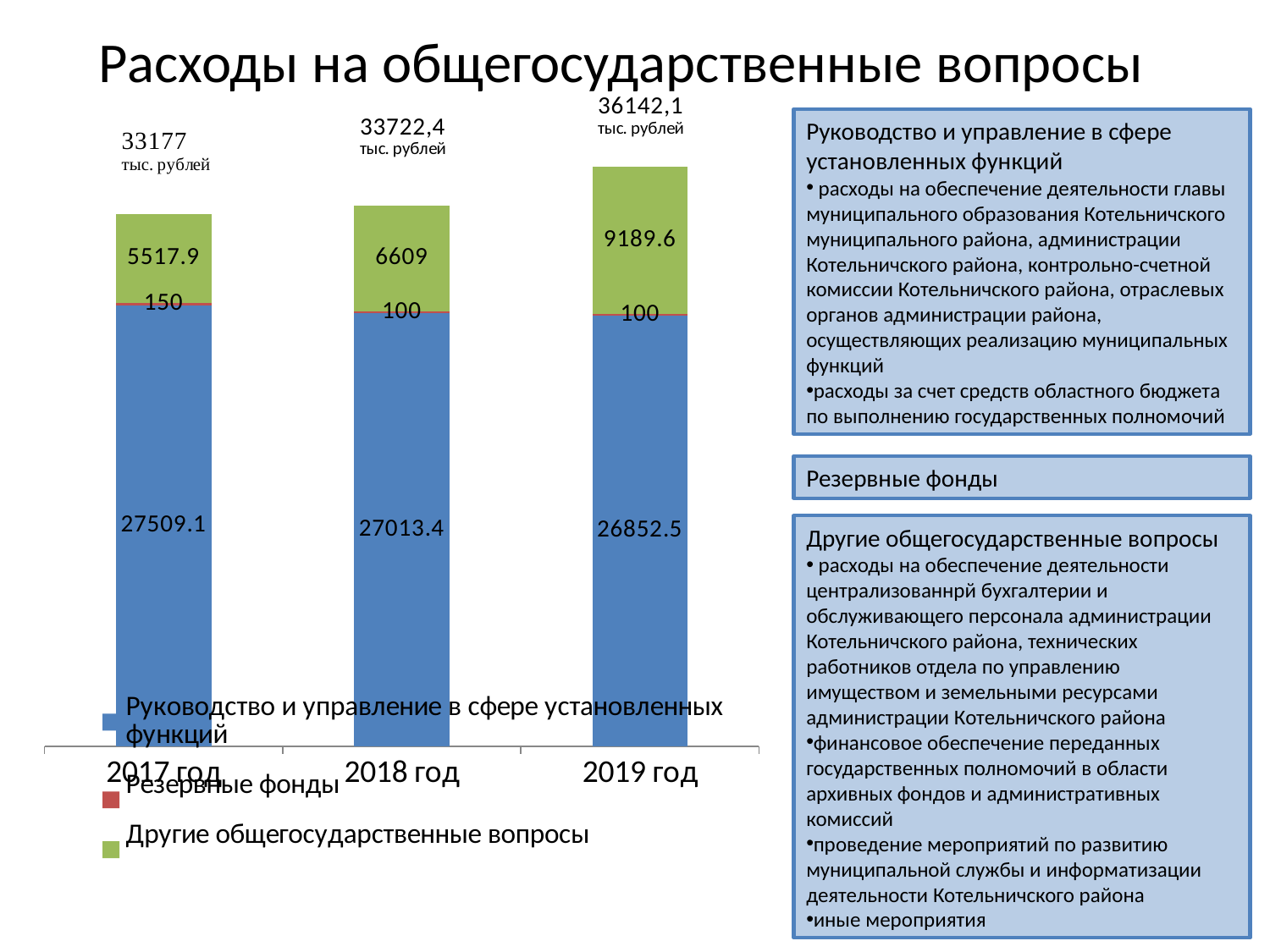
How many series does the legend list? 3 Which year has the highest value for Другие общегосударственные вопросы? 2019 год What is the value for Резервные фонды in 2018 год? 100 What is the value for Другие общегосударственные вопросы in 2018 год? 6609 What is the value for Руководство и управление в сфере установленных функций in 2017 год? 27509.1 How does the value for Руководство и управление в сфере установленных функций change from 2017 год to 2019 год? It falls What type of chart is shown on the slide? Stacked bar chart Which year has the lowest value for Руководство и управление в сфере установленных функций? 2019 год What is the value for Другие общегосударственные вопросы in 2019 год? 9189.6 Is the value for Резервные фонды larger in 2017 год or in 2018 год? 2017 год What is the difference between the Другие общегосударственные вопросы values for 2019 год and 2018 год? 2580.6 What is the total of the stacked bar for 2019 год? 36142,1 тыс. рублей